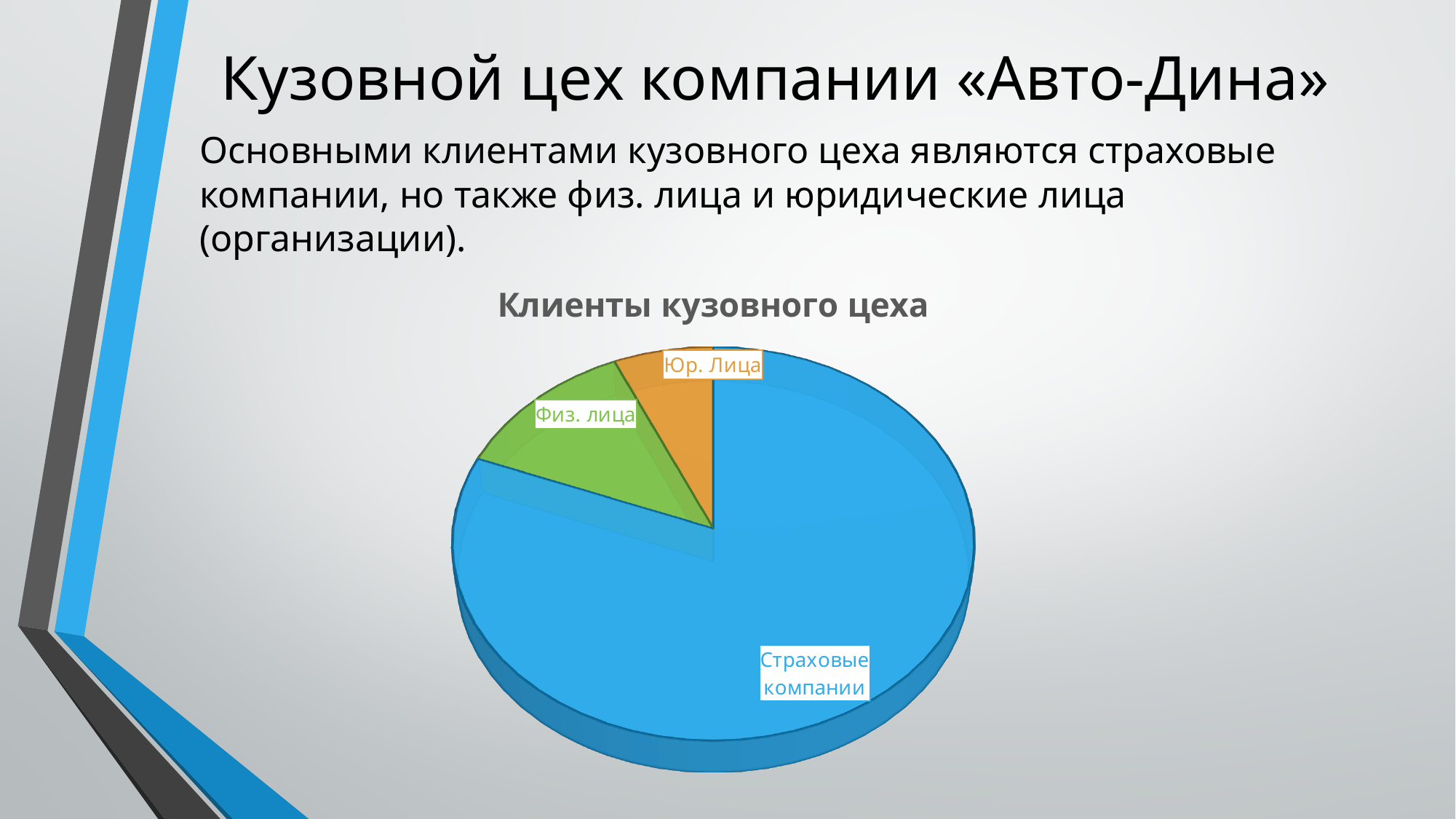
Which slice is larger, Физ. лица or Юр. Лица? Физ. лица What colour is the slice for Физ. лица? green What is the title of the chart? Клиенты кузовного цеха Which category has the largest share of the pie? Страховые компании Which category has the smallest share of the pie? Юр. Лица Which slice is larger, Страховые компании or Физ. лица? Страховые компании What kind of chart is shown on the slide? pie chart How many slices does the pie chart have? 3